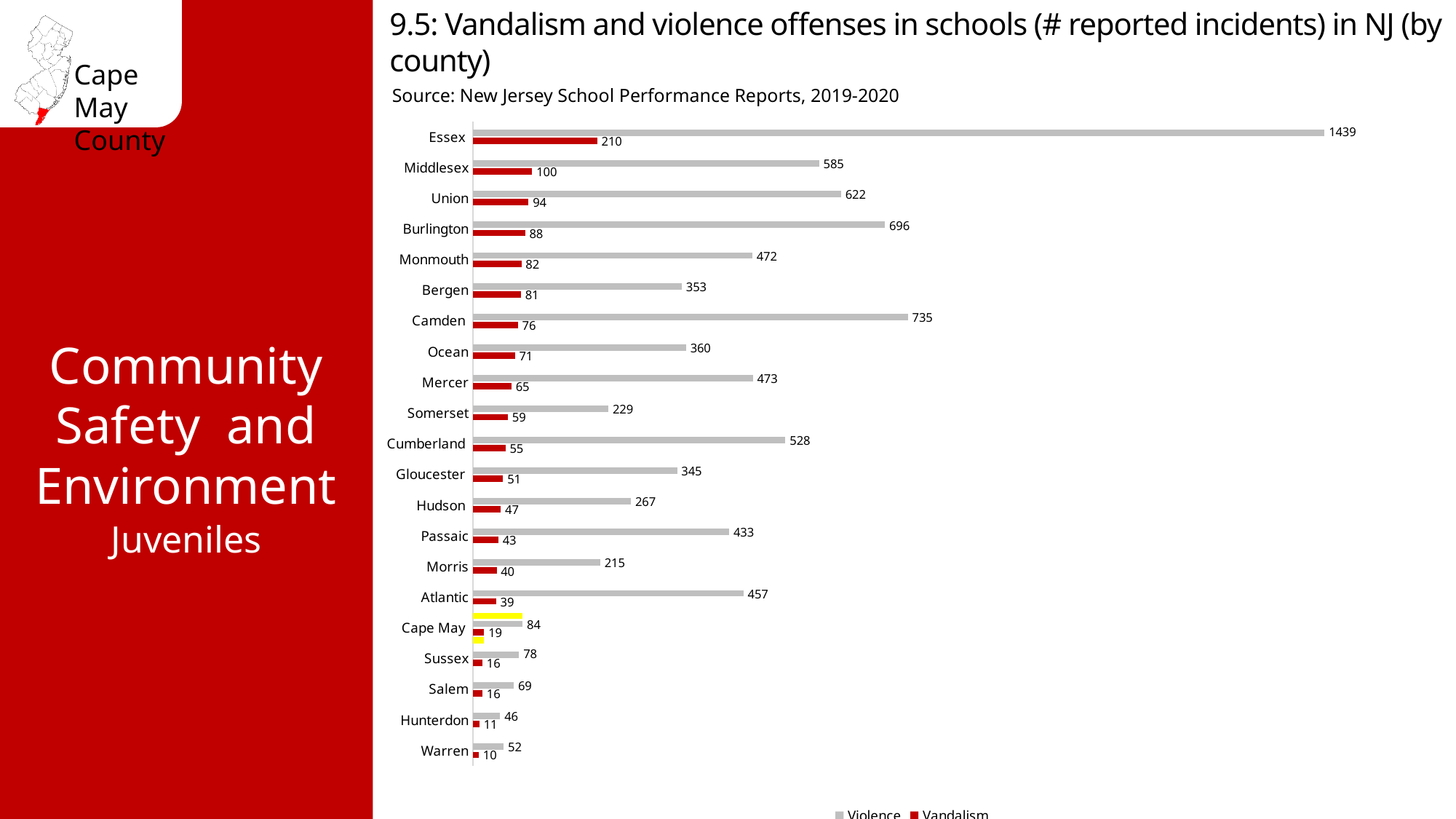
How many counties are shown in the chart? 21 What is the number of reported violence incidents in Camden County? 735 Which county has the lowest number of reported vandalism incidents? Warren Which county has the highest number of reported vandalism incidents? Essex How many series does the legend list? 2 What is the difference between the violence and vandalism incident counts for Cape May County? 65 Which colour represents the Vandalism series in the chart? Red Which county has the lowest number of reported violence incidents? Hunterdon What type of chart is shown on the slide? Bar chart What is the number of reported violence incidents in Essex County? 1439 Which county has more reported violence incidents, Camden or Burlington? Camden What is the number of reported vandalism incidents in Cape May County? 19